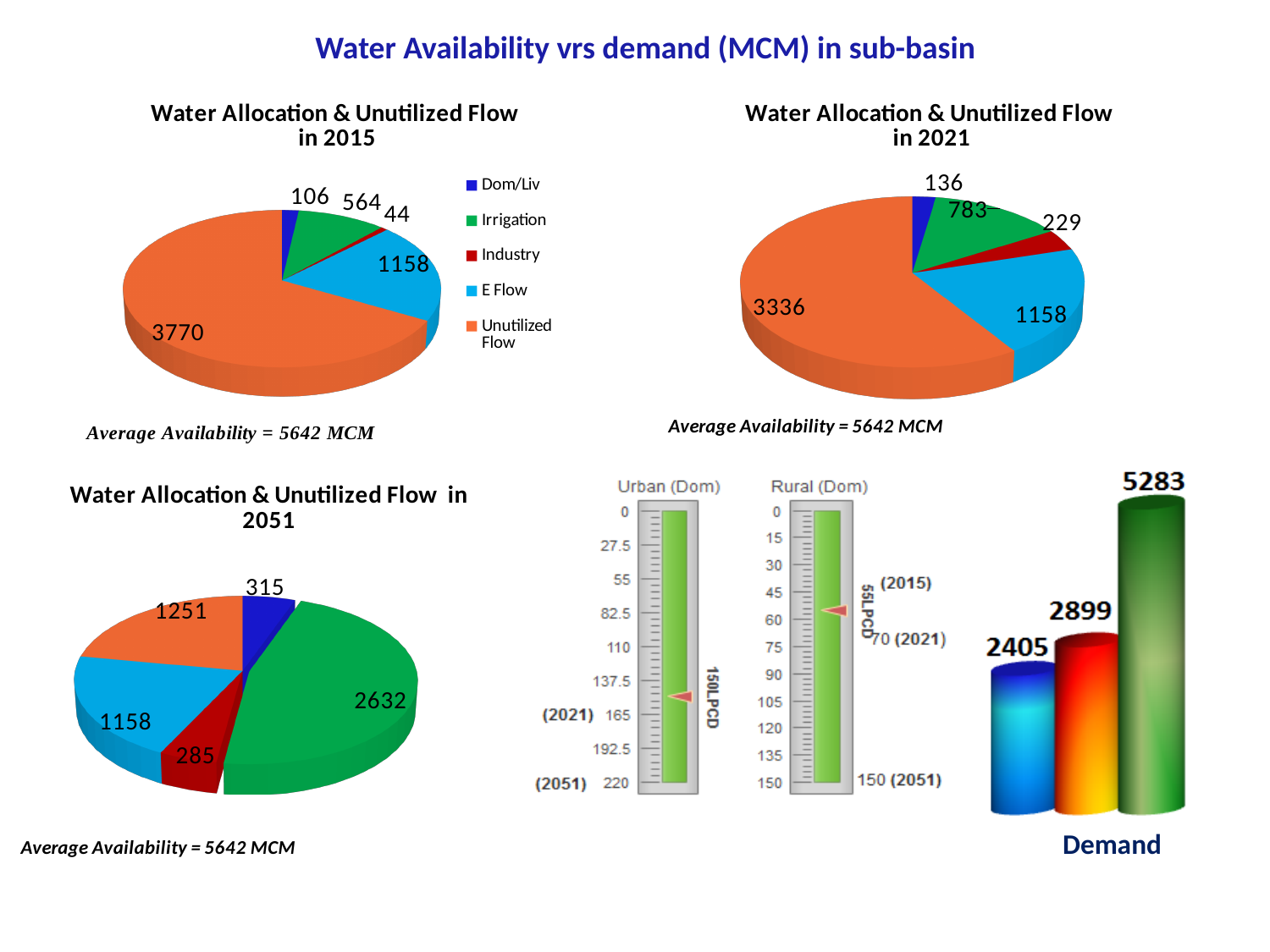
What is the difference between the Unutilized Flow value in the 2015 pie chart and the Unutilized Flow value in the 2021 pie chart? 434 In the 'Water Allocation & Unutilized Flow in 2051' pie chart, which is larger: Irrigation or E Flow? Irrigation In the 'Water Allocation & Unutilized Flow in 2015' pie chart, which category has the largest slice? Unutilized Flow In the 'Demand' chart at the bottom right, what is the difference between the tallest bar and the shortest bar? 2878 In the 'Water Allocation & Unutilized Flow in 2015' pie chart, which category has the smallest slice? Industry In the 'Water Allocation & Unutilized Flow in 2051' pie chart, what is the value of the Unutilized Flow slice? 1251 In the 'Water Allocation & Unutilized Flow in 2021' pie chart, what is the value for Irrigation? 783 In the 'Water Allocation & Unutilized Flow in 2021' pie chart, what is the value for Industry? 229 In the 'Water Allocation & Unutilized Flow in 2051' pie chart, which category has the largest slice? Irrigation In the 'Demand' chart at the bottom right, what is the value of the tallest bar? 5283 In the 'Water Allocation & Unutilized Flow in 2015' pie chart, what is the value of the Unutilized Flow slice? 3770 How many categories does the legend of the 2015 pie chart list? 5